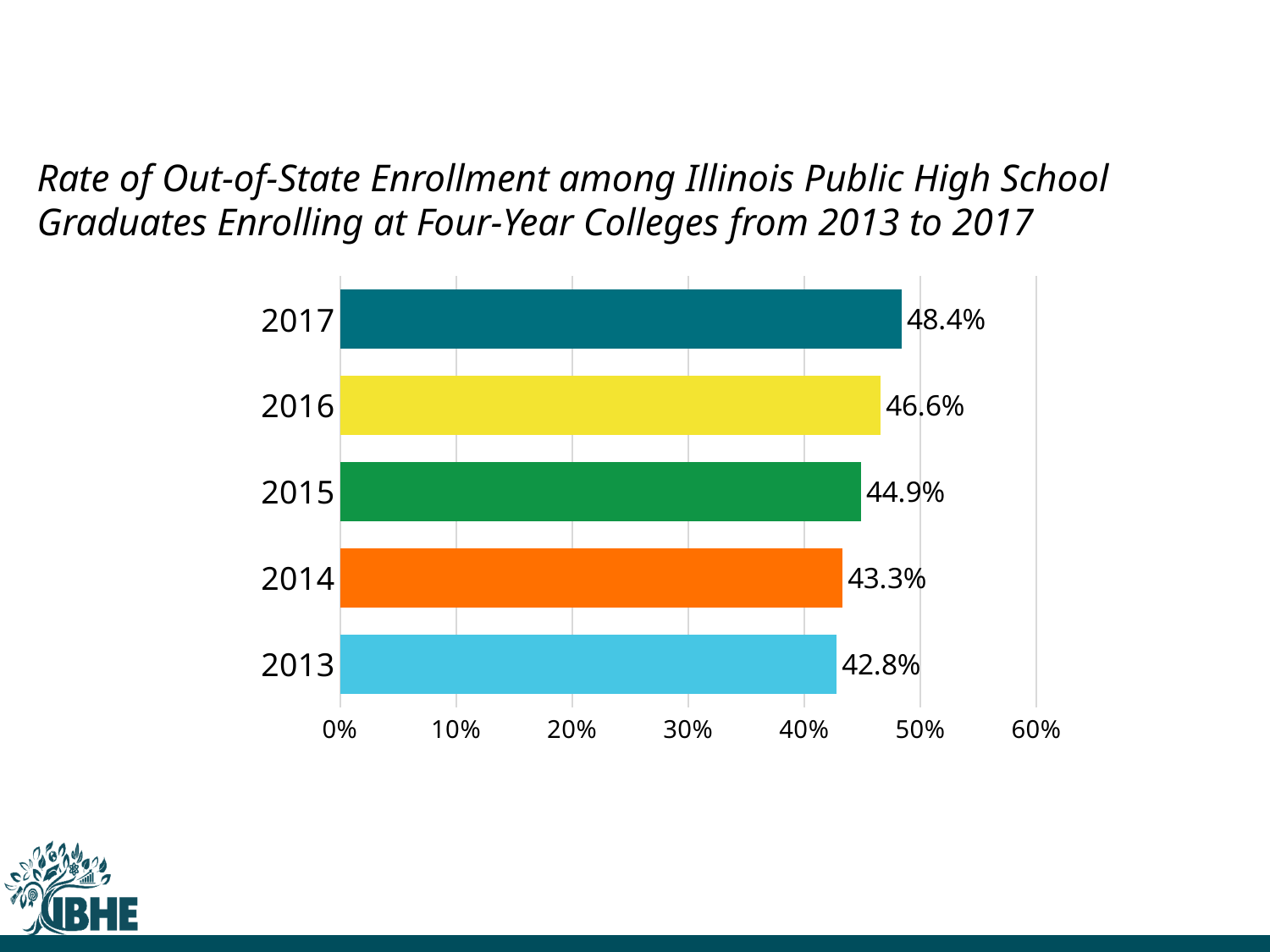
What is the difference between the 2017 and 2013 out-of-state enrollment rates? 5.6% Which year has the highest out-of-state enrollment rate? 2017 Which year has the lowest out-of-state enrollment rate? 2013 Does the out-of-state enrollment rate rise or fall from 2013 to 2017? Rise What is the out-of-state enrollment rate for 2015? 44.9% What is the out-of-state enrollment rate for 2017? 48.4% What is the out-of-state enrollment rate for 2013? 42.8% What kind of chart is shown on the slide? Bar chart Is the value for 2014 greater or less than 40%? greater Which year has a higher out-of-state enrollment rate, 2014 or 2016? 2016 What is the difference between the 2016 and 2015 out-of-state enrollment rates? 1.7% How many years are shown in the chart? 5